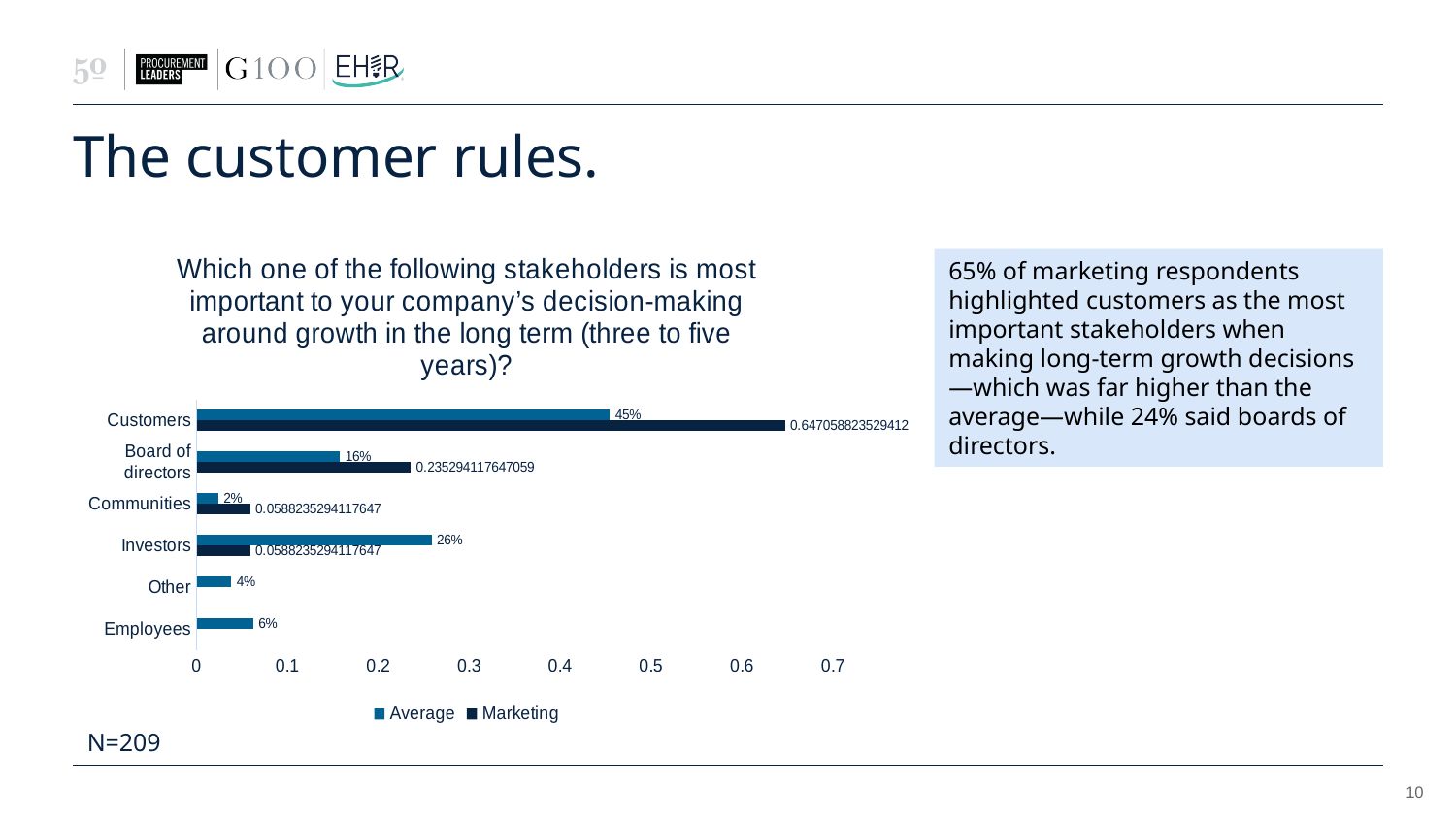
What is the difference between the Average values for Investors and Board of directors? 10% What is the Average value for Customers? 45% Is the Marketing value for Customers greater or less than 0.6? greater What is the Marketing value for Board of directors? 0.235294117647059 Which category has the highest Average value? Customers How many series does the legend list? 2 Which category has the lowest Average value? Communities Which is larger, the Average value for Investors or the Average value for Board of directors? Investors What is the Average value for Investors? 26% How many categories are shown on the chart? 6 What kind of chart is shown on the slide? Bar chart What is the Marketing value for Customers? 0.647058823529412